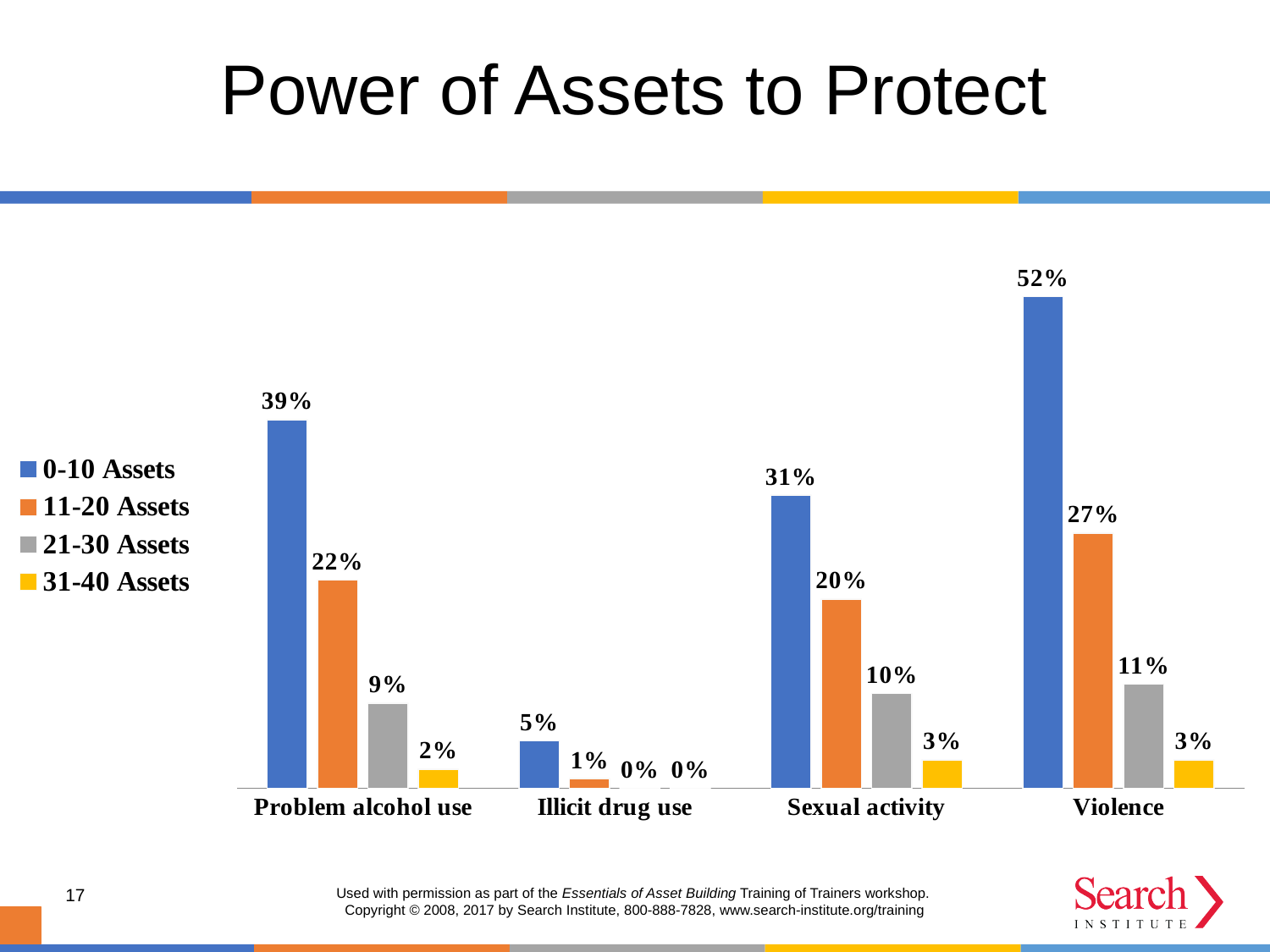
Which colour represents the 31-40 Assets series? Yellow How many series does the legend list? 4 What is the value for 0-10 Assets in the Violence category? 52% What is the value for 21-30 Assets in the Problem alcohol use category? 9% Which category has the lowest value for 11-20 Assets? Illicit drug use What is the value for 11-20 Assets in the Sexual activity category? 20% Which category has the highest value for 0-10 Assets? Violence What is the value for 31-40 Assets in the Illicit drug use category? 0% Which is larger: the 11-20 Assets value for Problem alcohol use or the 11-20 Assets value for Violence? Violence How many categories are shown on the x axis? 4 What kind of chart is shown on the slide? Bar chart What is the difference between the 0-10 Assets and 31-40 Assets values in the Violence category? 49%